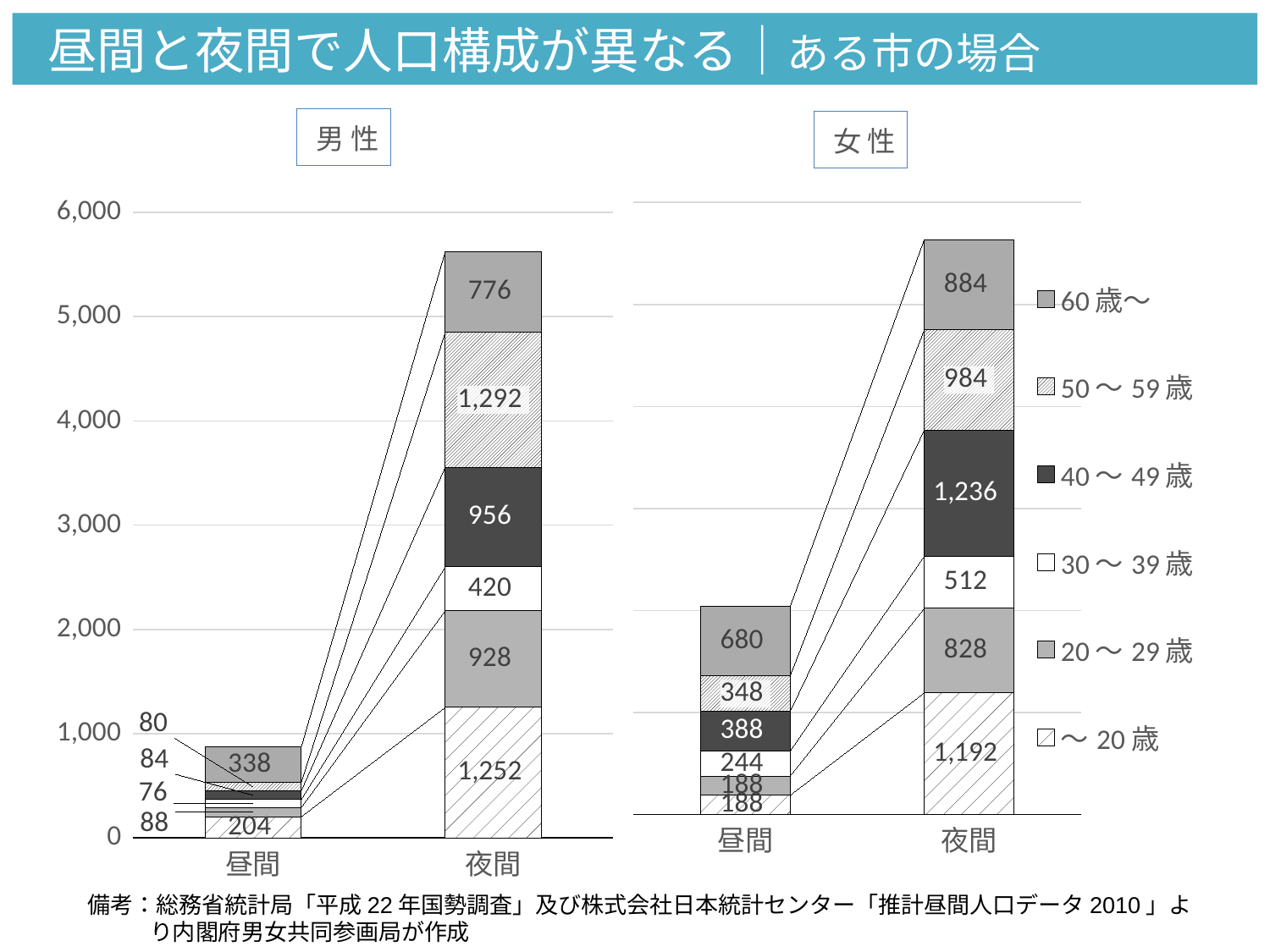
In the 男性 chart, what is the value for ～20 歳 in the 夜間 bar? 1,252 In the 女性 chart, what is the total of the 夜間 stacked bar? 5,636 In the 女性 chart, what is the value for 60 歳～ in the 昼間 bar? 680 In the 男性 chart, what is the value for 60 歳～ in the 夜間 bar? 776 In the 男性 chart, is the total of the 昼間 bar greater or less than 1,000? less In the 女性 chart, what is the difference between the 50～59 歳 value and the 30～39 歳 value in the 夜間 bar? 472 What kind of chart is used on this slide? Stacked bar chart In the 男性 chart, which is larger in the 夜間 bar: 20～29 歳 or 40～49 歳? 40～49 歳 How many series does the legend list? 6 In the 男性 chart, which age group has the smallest value in the 夜間 bar? 30～39 歳 In the 女性 chart, what is the value for 40～49 歳 in the 夜間 bar? 1,236 In the 女性 chart, which age group has the largest value in the 夜間 bar? 40～49 歳